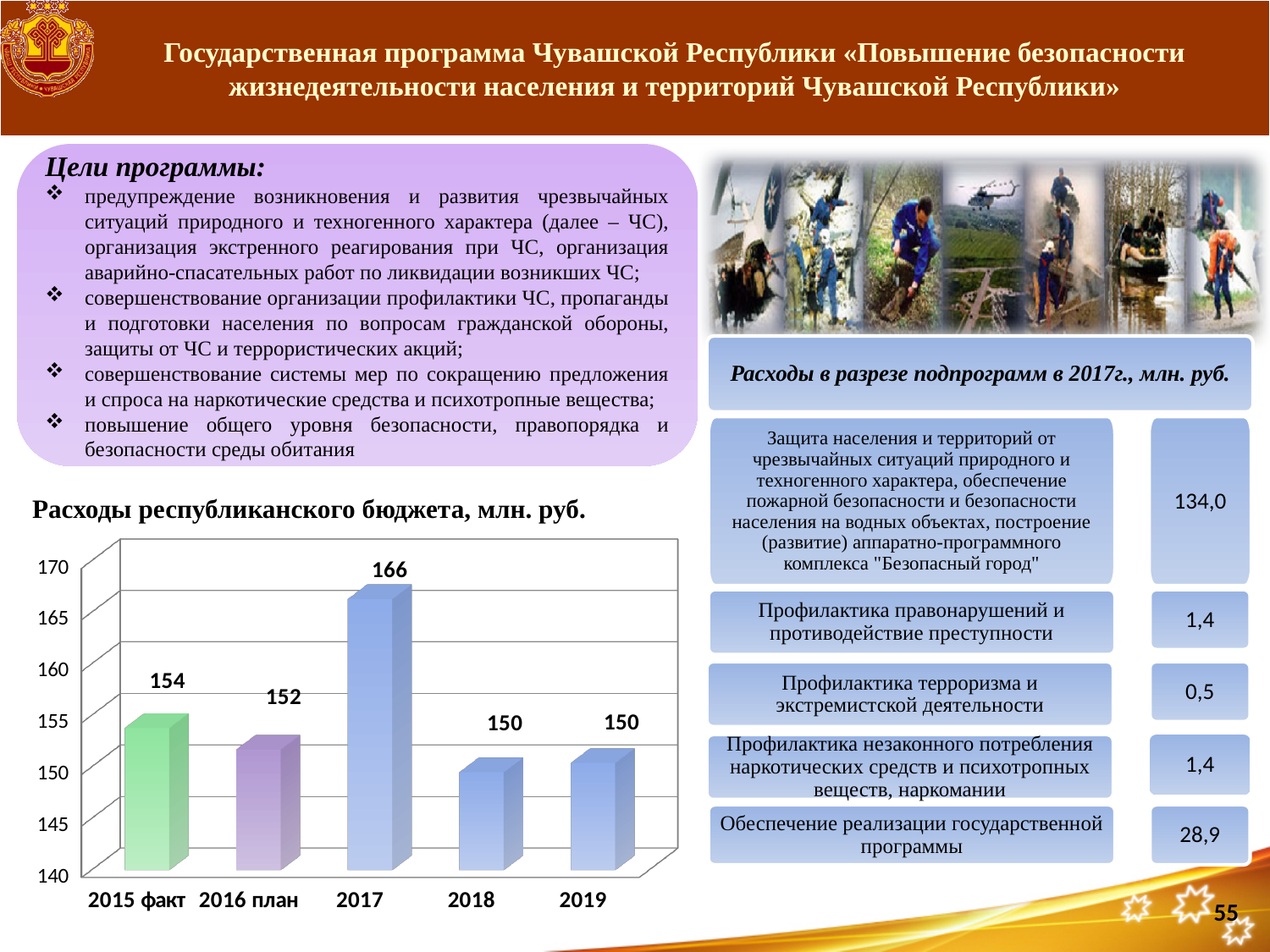
What is the difference between the values for '2015 факт' and '2016 план'? 2 Is the value for 2017 greater or less than 160? greater What is the difference between the values for 2017 and 2018? 16 What is the value for '2016 план' in the chart? 152 What is the value for 2017 in the chart 'Расходы республиканского бюджета, млн. руб.'? 166 What is the title of the chart on the slide? Расходы республиканского бюджета, млн. руб. What is the value for 2019 in the chart? 150 Which is larger, the value for '2015 факт' or the value for 2018? 2015 факт What is the value for '2015 факт' in the chart? 154 What kind of chart is 'Расходы республиканского бюджета, млн. руб.'? bar chart Which category has the highest value in the chart? 2017 How many categories are shown on the x axis of the chart? 5